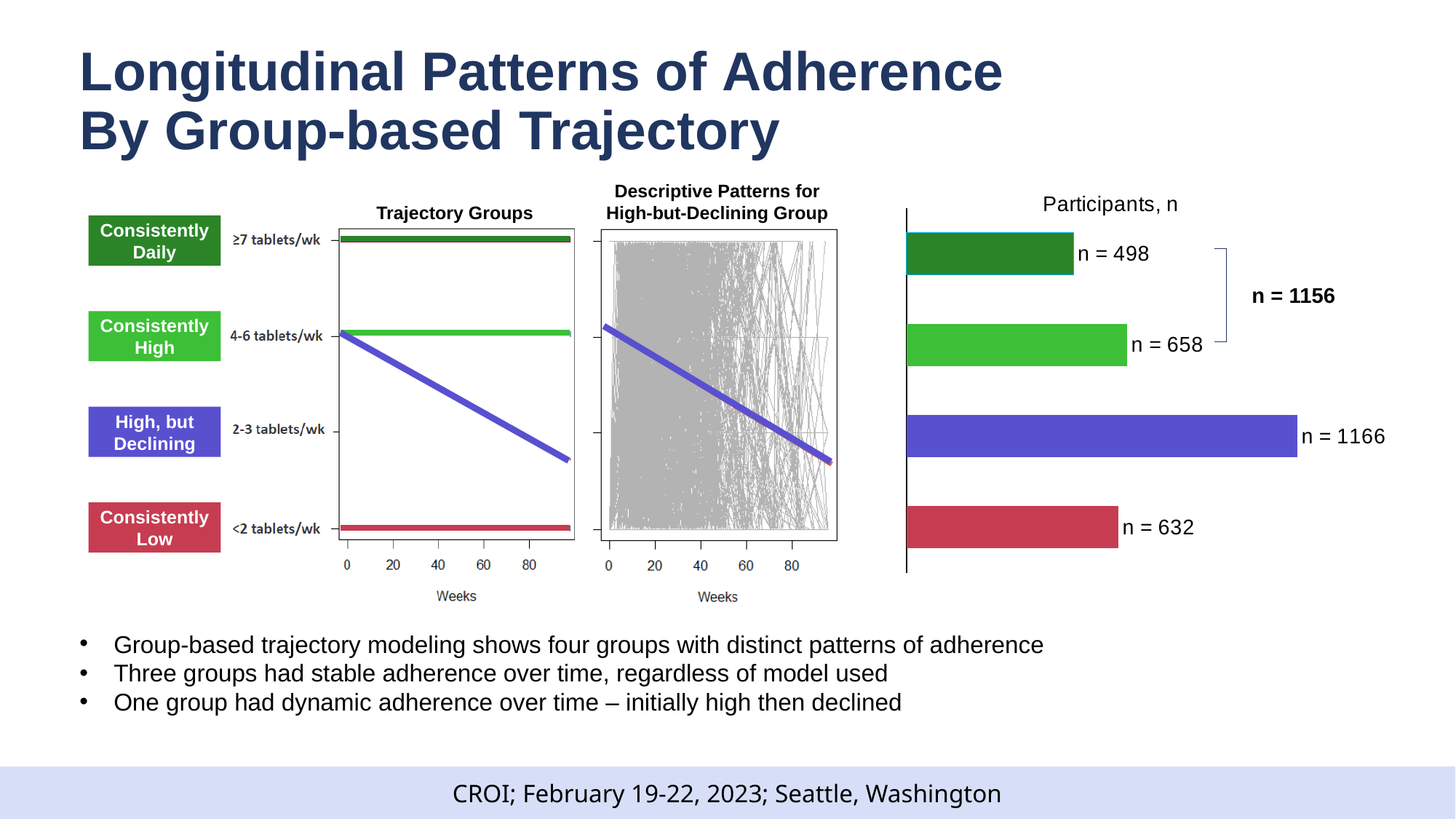
In the Trajectory Groups chart, what adherence level is labelled on the y axis for the Consistently Daily group? ≥7 tablets/wk What kind of chart is the Participants, n chart? Bar chart In the Participants, n bar chart, what combined n is shown for the Consistently Daily and Consistently High groups together? n = 1156 In the Participants, n bar chart, how many participants are in the Consistently Daily group? n = 498 How many trajectory groups are shown in the Participants, n bar chart? 4 In the Participants, n bar chart, what is the difference in participants between the High, but Declining group and the Consistently Low group? 534 In the Participants, n bar chart, which group has the largest number of participants? High, but Declining In the Participants, n bar chart, which group has more participants: Consistently High or Consistently Low? Consistently High In the Participants, n bar chart, how many participants are in the Consistently Low group? n = 632 In the Participants, n bar chart, how many participants are in the High, but Declining group? n = 1166 In the Participants, n bar chart, which group has the smallest number of participants? Consistently Daily In the Trajectory Groups chart, does the High, but Declining line rise or fall over the weeks? Fall